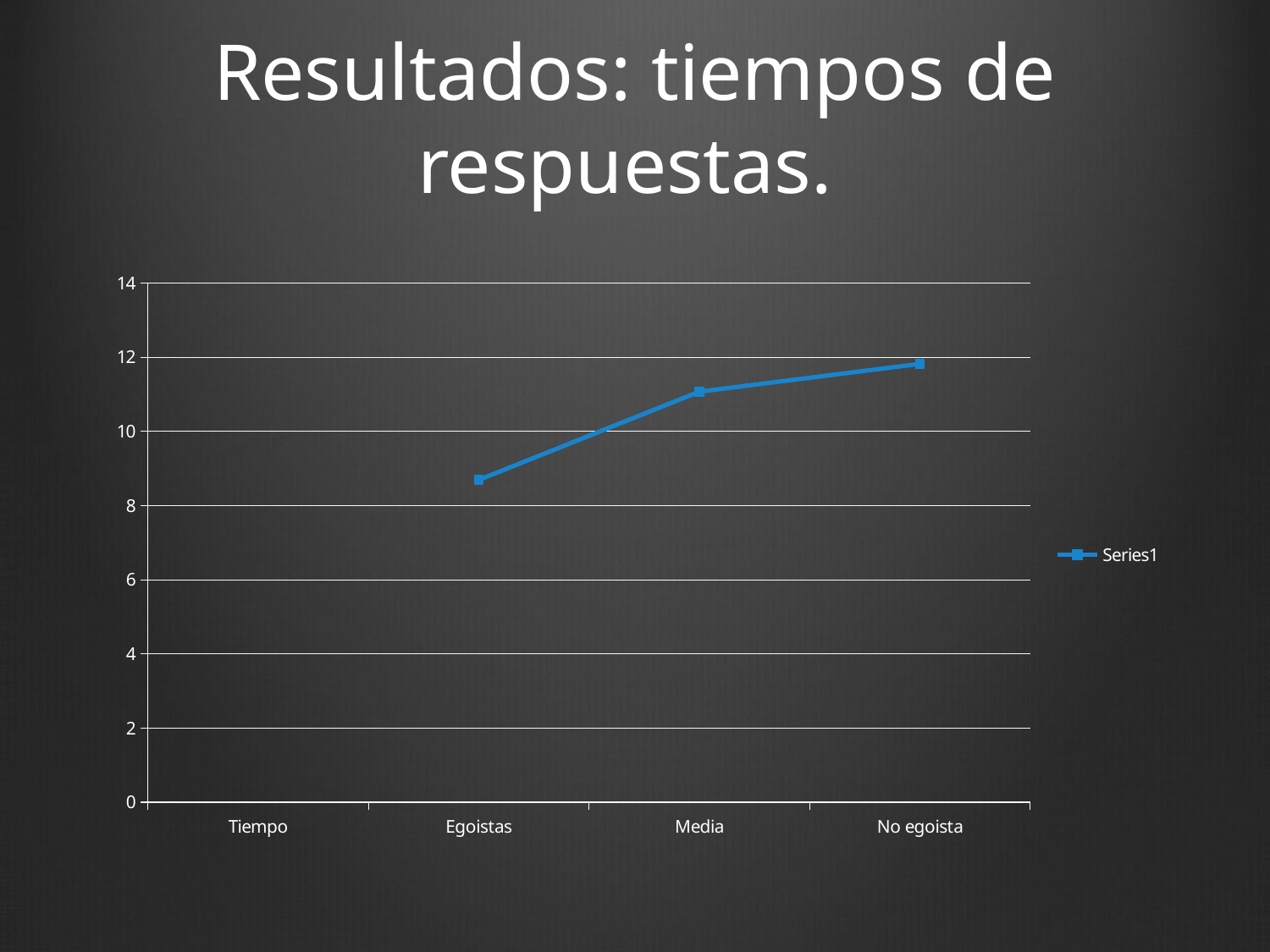
Is the value for Egoistas greater or less than 10? less How many series does the legend list? 1 Is the value for Egoistas greater or less than 8? greater Which category has the highest plotted value? No egoista What is the name of the series in the legend? Series1 What kind of chart is shown on the slide? line chart Which category has the lowest plotted value? Egoistas Is the value for Media greater or less than 10? greater Do the plotted values rise or fall from Egoistas to No egoista? rise How many data points are plotted on the line? 3 How many category labels are shown on the x axis? 4